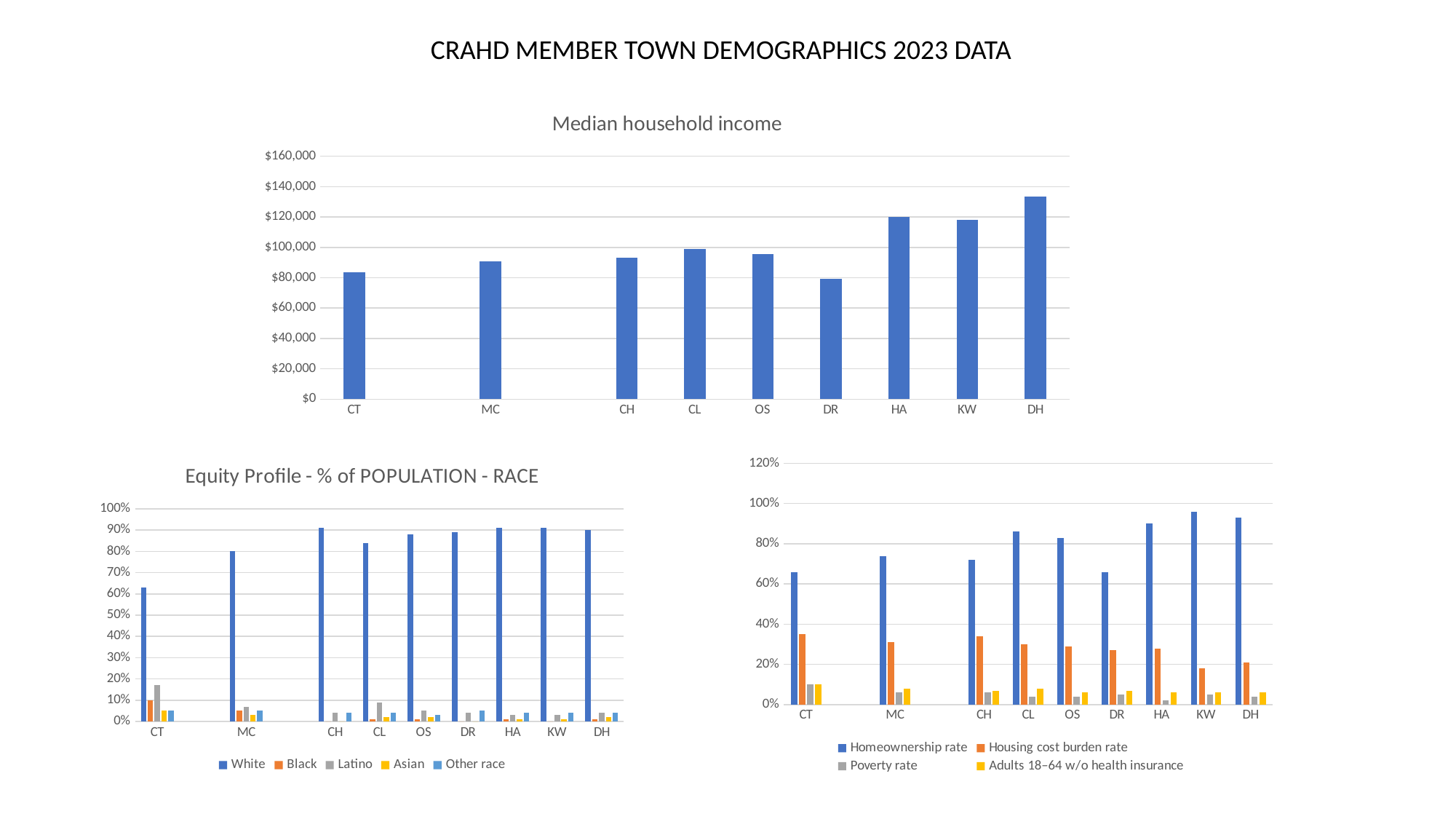
On the Median household income chart, is the value for DH greater or less than $120,000? greater On the Median household income chart, which town has the highest median household income? DH How many towns are shown on the Median household income chart? 9 On the Median household income chart, which town has the lowest median household income? DR On the Median household income chart, which is larger, the median household income for HA or for CH? HA What kind of chart is the Median household income chart? bar chart On the bottom-right chart, is the Homeownership rate for KW greater or less than 80%? greater On the Median household income chart, is the value for CT greater or less than $100,000? less On the bottom-right chart, which town has the highest Homeownership rate? KW How many series does the legend of the Equity Profile - % of POPULATION - RACE chart list? 5 On the Equity Profile - % of POPULATION - RACE chart, which town has the lowest White share of population? CT On the Equity Profile - % of POPULATION - RACE chart, which town has the highest Latino share of population? CT